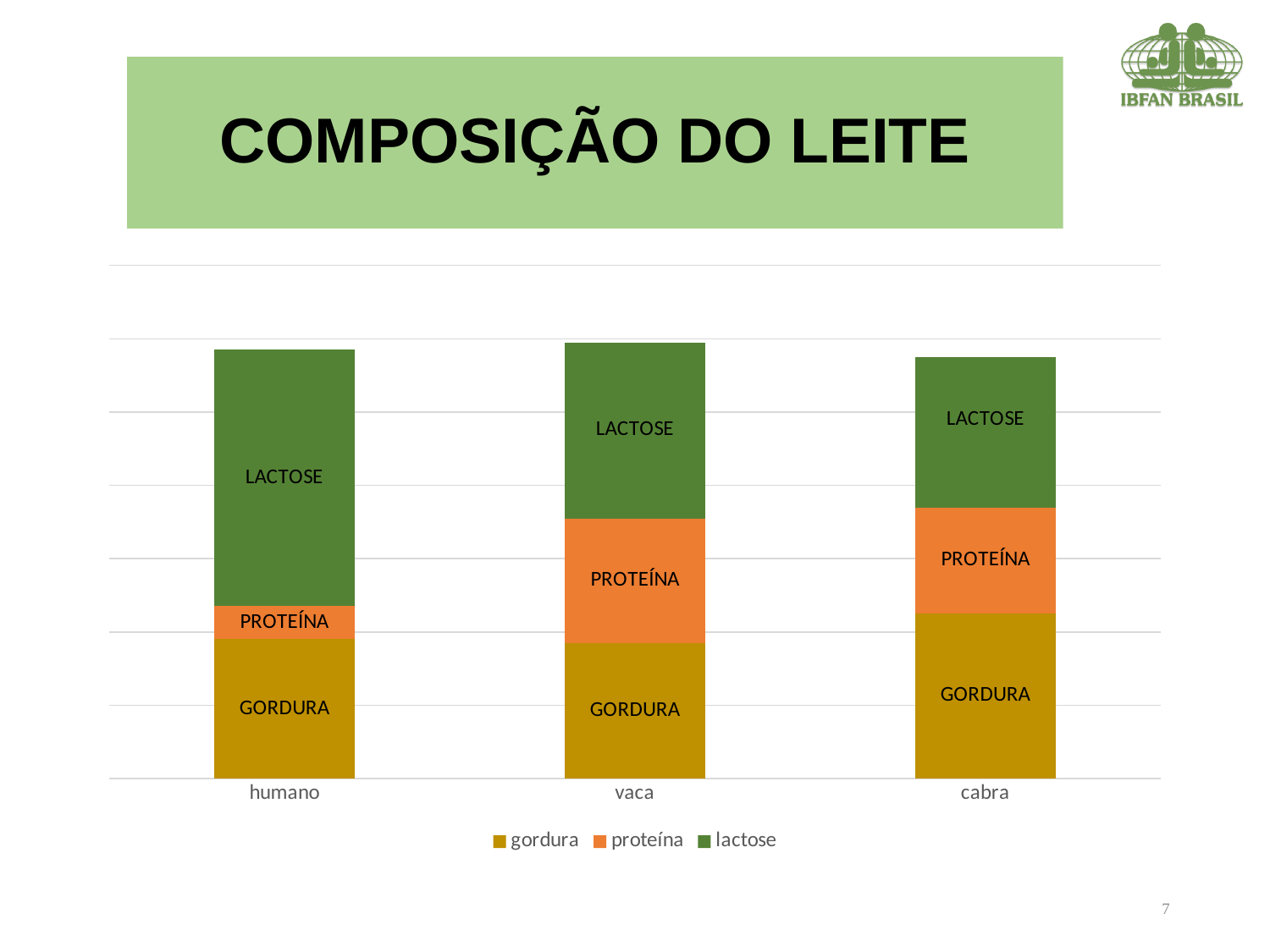
How many series does the chart legend list? 3 Which category has the largest gordura segment? cabra What kind of chart is shown on the slide? stacked bar chart Is the lactose segment larger for humano or for vaca? humano Which category has the smallest proteína segment? humano Which category has the largest lactose segment? humano What are the three categories shown on the x axis? humano, vaca, cabra Is the gordura segment larger for cabra or for humano? cabra Is the proteína segment larger for humano or for cabra? cabra How many categories are shown on the x axis of the chart? 3 Which series is shown at the bottom of each stacked bar? gordura